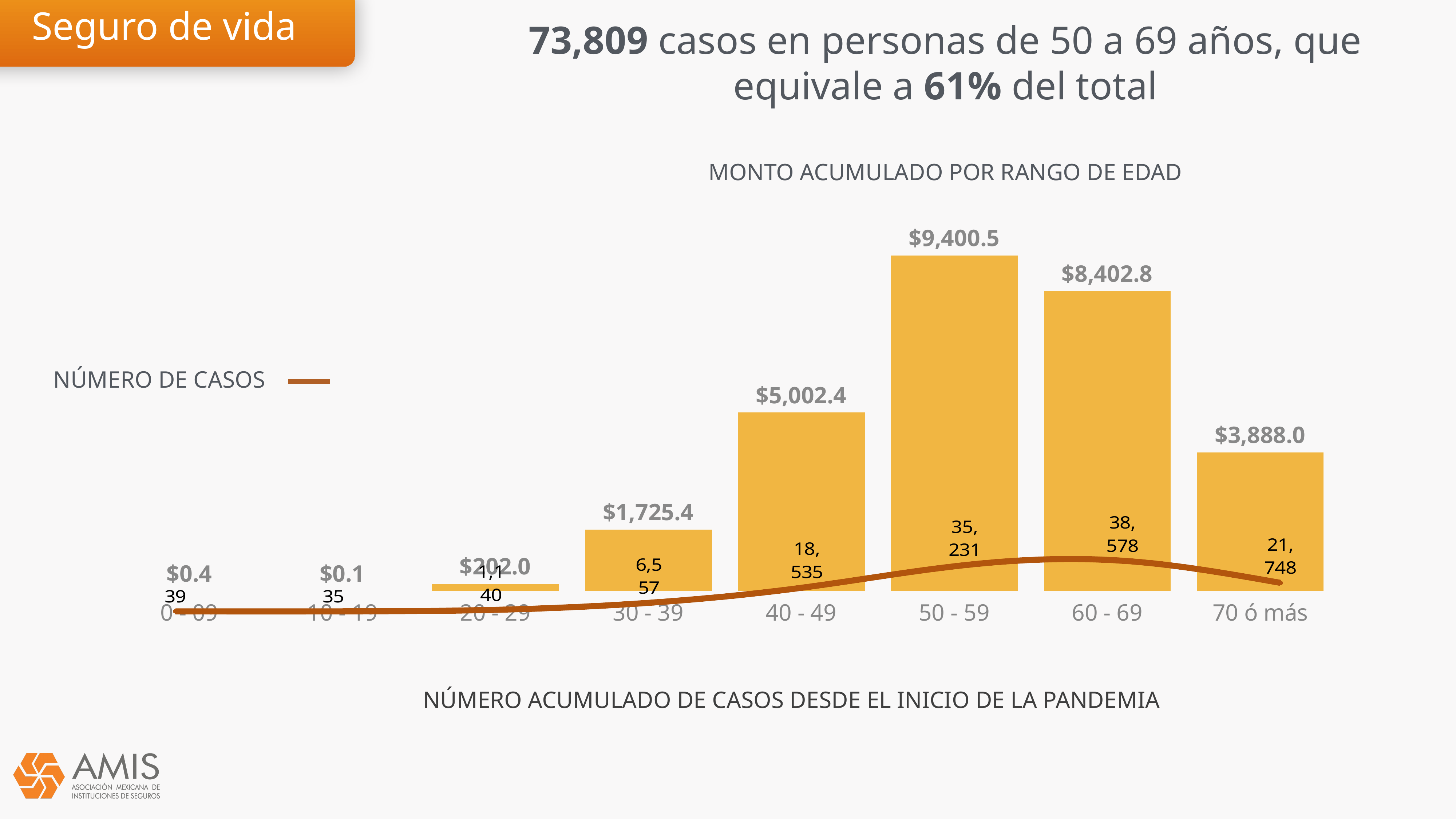
What is the monto acumulado for the 30 - 39 age range? $1,725.4 Which age range has the highest monto acumulado? 50 - 59 Which age range has the lowest monto acumulado? 10 - 19 What is the monto acumulado for the 50 - 59 age range? $9,400.5 How does the monto acumulado change across the age ranges from 0 - 09 to 70 ó más? Rises up to 50 - 59, then falls What series does the line in the legend represent? NÚMERO DE CASOS What kind of chart is shown? Bar chart with a line series Which has a larger monto acumulado, 40 - 49 or 70 ó más? 40 - 49 What is the número de casos for the 60 - 69 age range? 38,578 How many age ranges are shown on the x axis? 8 What is the difference between the monto acumulado for 50 - 59 and for 60 - 69? $997.7 Which age range has the highest número de casos on the line? 60 - 69